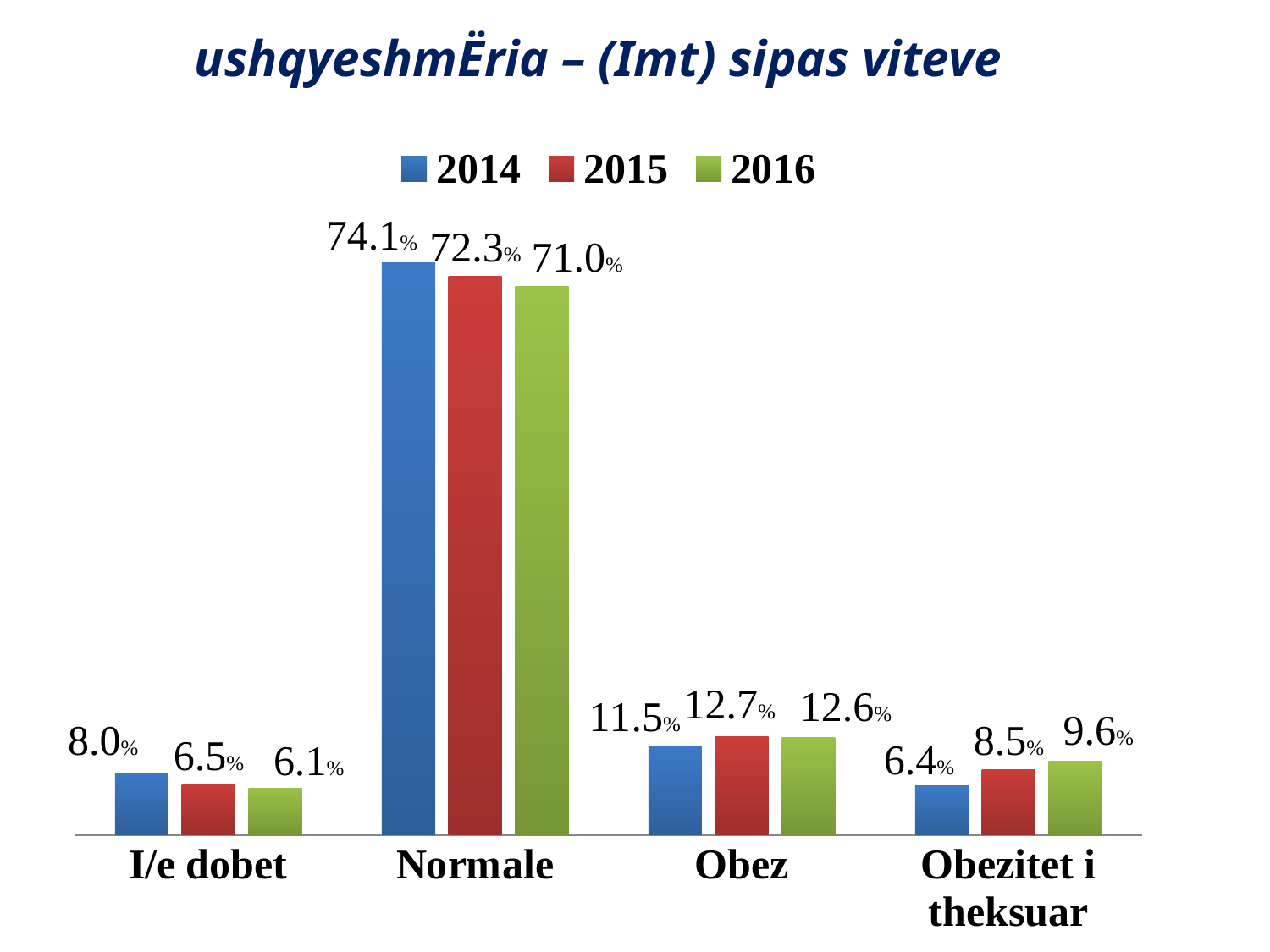
What is the value for I/e dobet in 2016? 6.1% How many categories are shown on the x axis? 4 What kind of chart is shown on the slide? Bar chart What is the value for Normale in 2014? 74.1% Which category has the highest value in 2016? Normale How many series does the legend list? 3 Which is larger for Obezitet i theksuar: the 2015 value or the 2016 value? 2016 What is the value for Obez in 2015? 12.7% Do the values for Normale rise or fall from 2014 to 2016? Fall What is the difference between the 2014 and 2016 values for Normale? 3.1% What is the value for Obezitet i theksuar in 2016? 9.6% Which category has the lowest value in 2014? Obezitet i theksuar